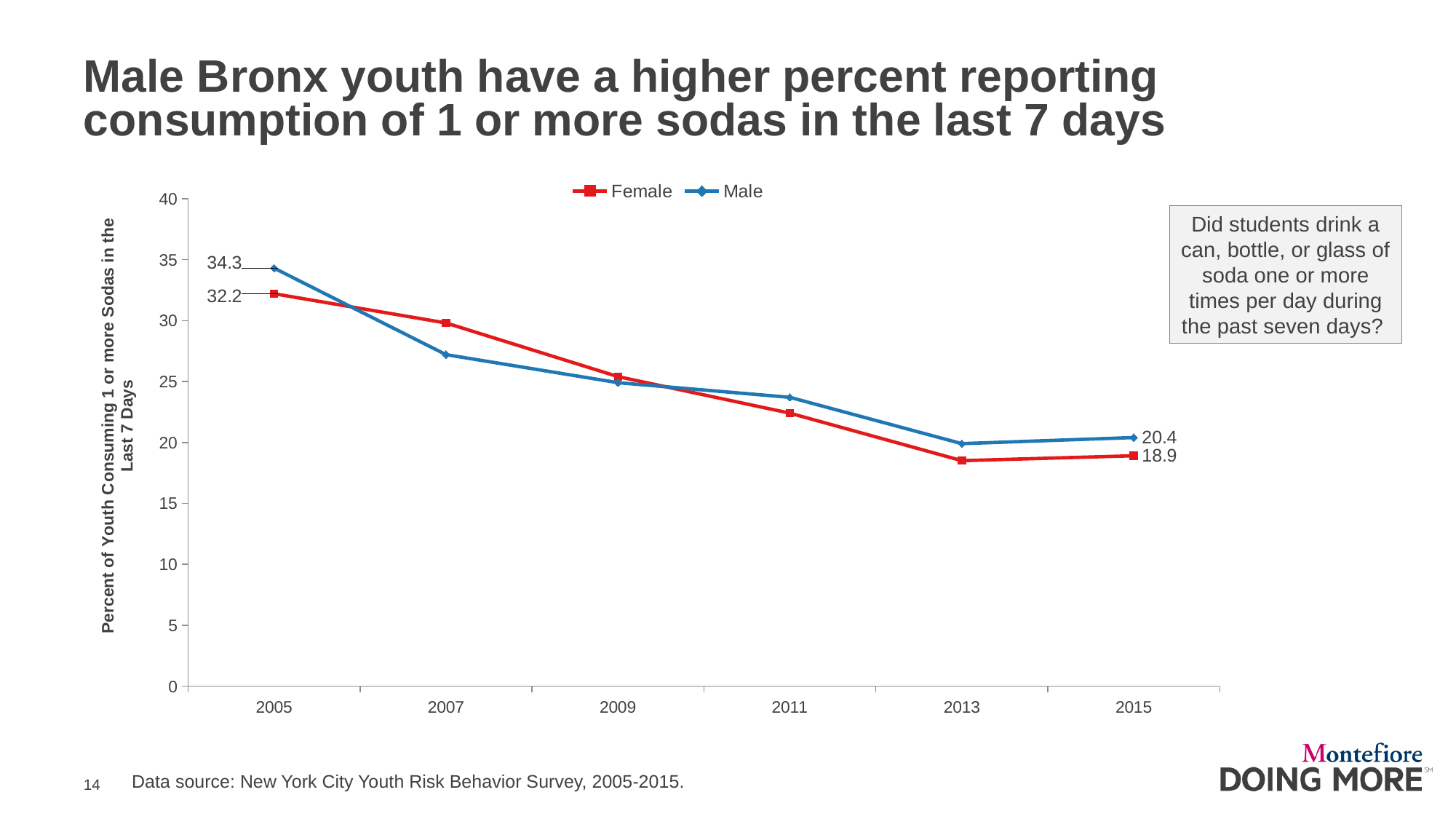
What is the value for Female in 2005? 32.2 What is the value for Female in 2015? 18.9 Do the values for Male generally rise or fall from 2005 to 2015? fall What is the value for Male in 2015? 20.4 By how much did the Male value fall from 2005 to 2015? 13.9 What is the difference between the Male and Female values in 2005? 2.1 How many series does the legend list? 2 What is the value for Male in 2005? 34.3 How many years are plotted along the x axis? 6 Is the value for Female in 2007 greater or less than 25? greater Which series has the higher value in 2015, Male or Female? Male What type of chart is shown on the slide? line chart